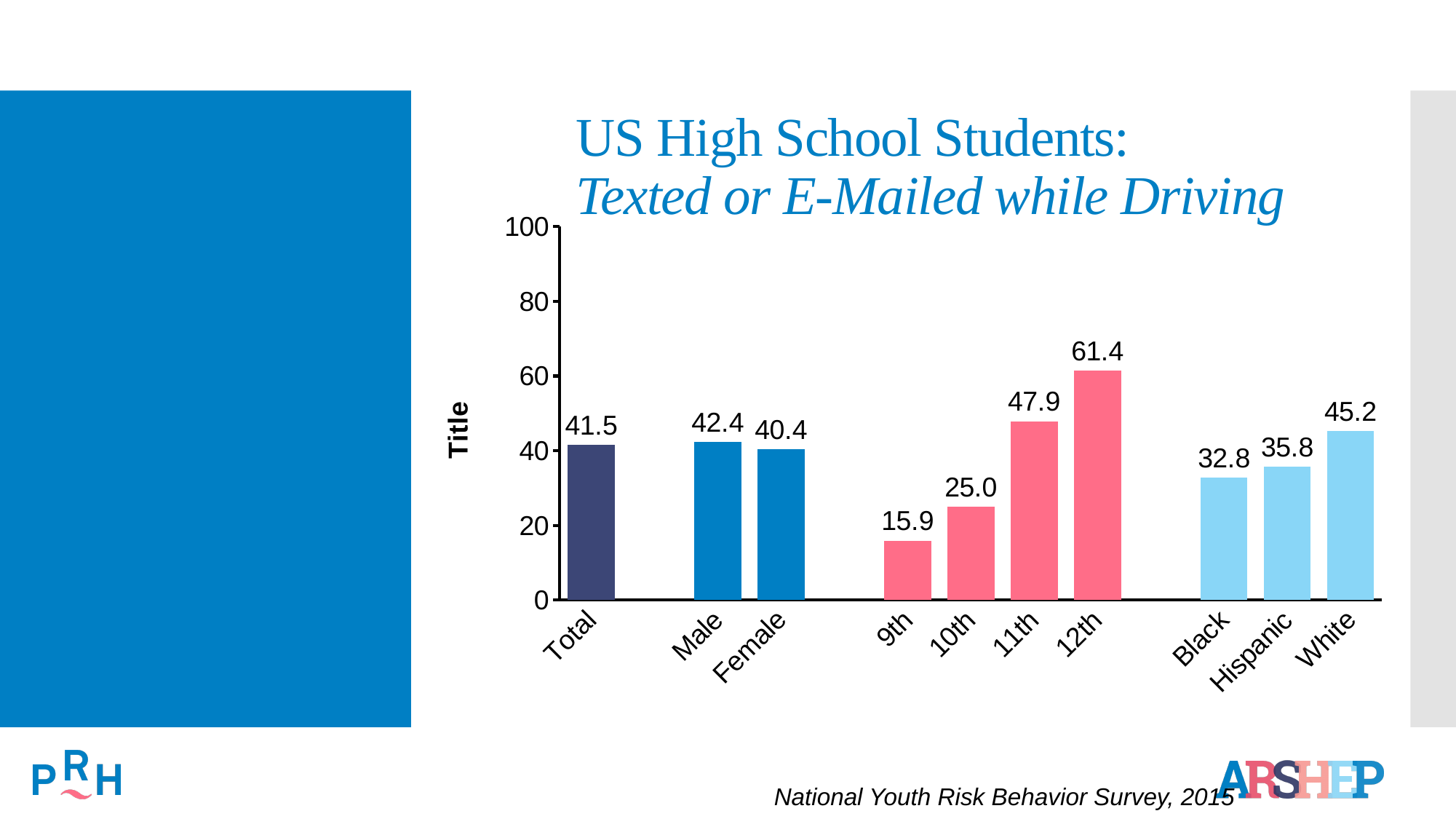
Do the values rise or fall from 9th grade to 12th grade? rise What is the value for 12th grade students? 61.4 What is the value for Hispanic students? 35.8 Which category has the lowest value? 9th What is the value for Female students? 40.4 Which is larger, the value for White students or the value for Black students? White What kind of chart is shown on the slide? bar chart Which category has the highest value? 12th Is the value for 11th grade students greater or less than 40? greater What is the difference between the values for Male and Female students? 2.0 What is the difference between the values for 12th and 9th grade students? 45.5 How many categories are shown on the x axis? 10